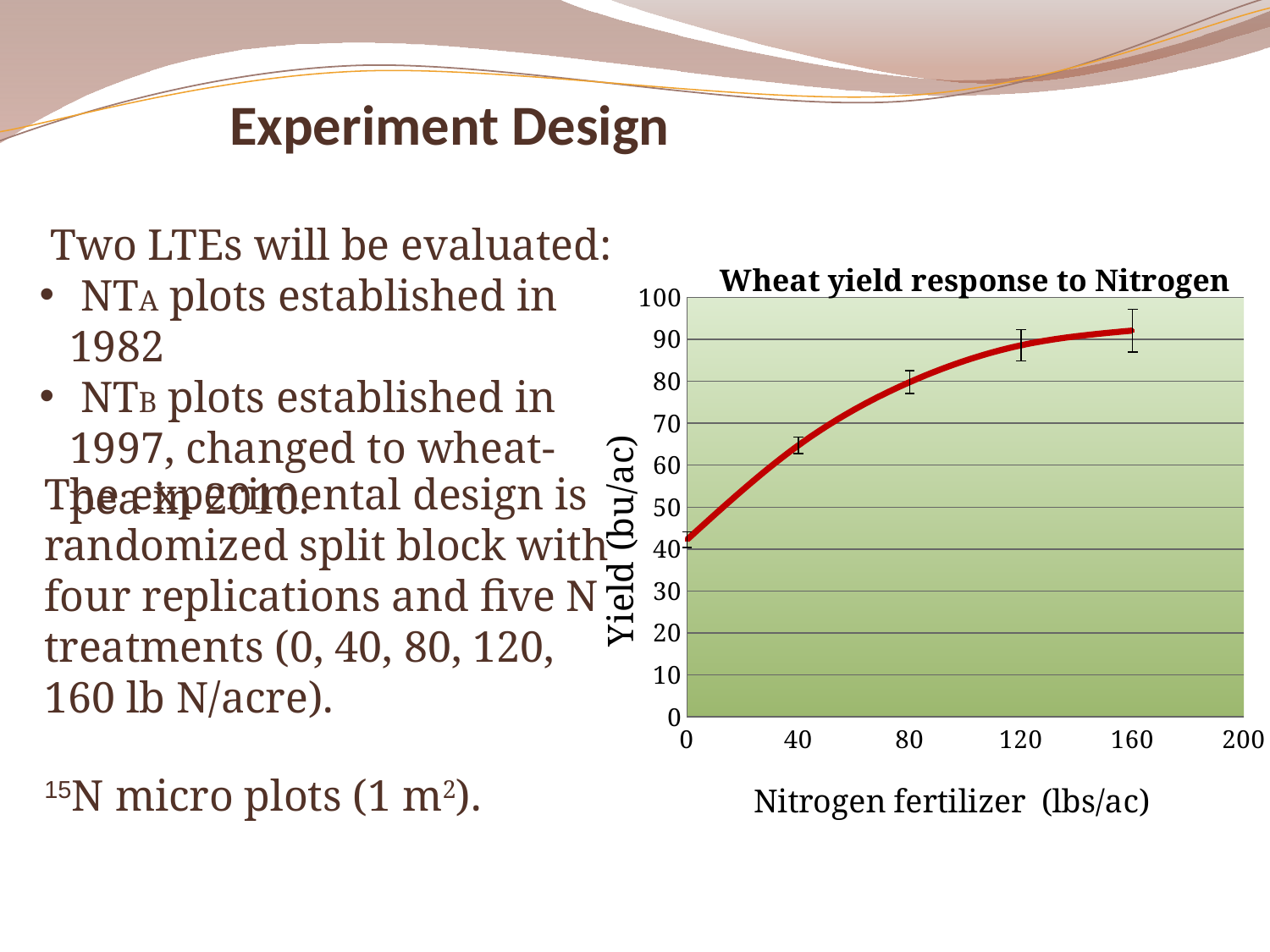
Is the yield at 0 lbs/ac of nitrogen fertilizer greater or less than 50? less Is the yield at 120 lbs/ac of nitrogen fertilizer greater or less than 80? greater What is the title of the chart? Wheat yield response to Nitrogen What kind of chart is shown on the slide? line chart Which nitrogen fertilizer rate gives the higher yield, 0 lbs/ac or 160 lbs/ac? 160 lbs/ac What is the label of the y axis of the chart? Yield (bu/ac) How many data points (with error bars) are plotted on the chart? 5 Is the yield at 40 lbs/ac of nitrogen fertilizer greater or less than 60? greater Does wheat yield rise or fall as nitrogen fertilizer increases along the x axis? rise At which nitrogen fertilizer rate is the yield lowest? 0 lbs/ac